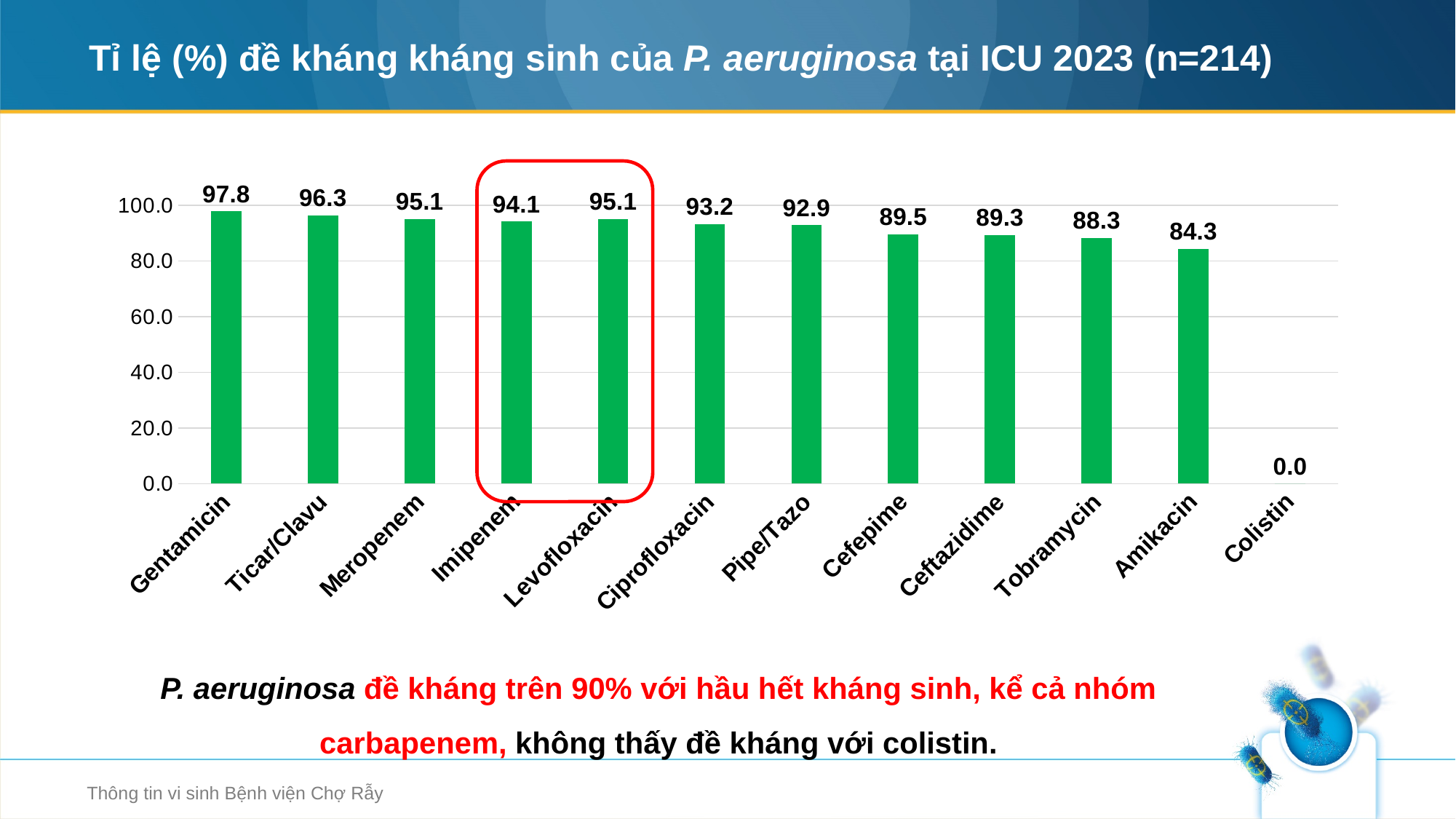
How many antibiotics are shown on the x axis? 12 What is the resistance rate for Colistin? 0.0 Which antibiotic has the highest resistance rate? Gentamicin Which antibiotic has the lowest resistance rate? Colistin Which two antibiotics are enclosed by the red outline on the chart? Imipenem and Levofloxacin What is the resistance rate for Amikacin? 84.3 What is the difference between the resistance rates for Levofloxacin and Imipenem? 1.0 What is the difference between the resistance rates for Gentamicin and Amikacin? 13.5 Which has a higher resistance rate, Meropenem or Cefepime? Meropenem Is the value for Tobramycin greater or less than 80.0? greater What is the resistance rate for Gentamicin? 97.8 What kind of chart is shown on the slide? Bar chart